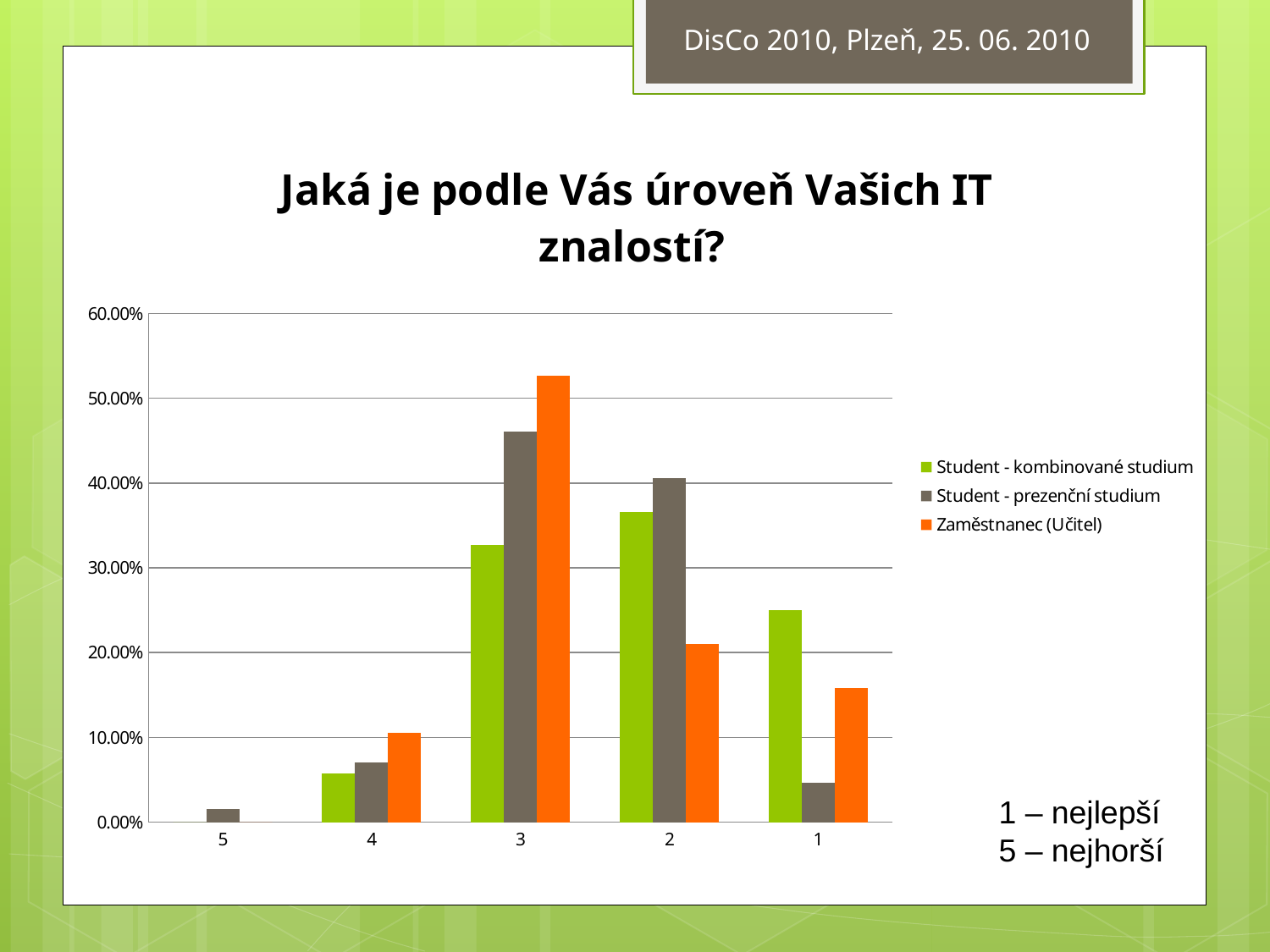
How many series does the legend list? 3 For which category is the value for Student - kombinované studium highest? 2 Is the value for Zaměstnanec (Učitel) at category 3 greater or less than 50.00%? greater At category 2, which is larger: Student - prezenční studium or Zaměstnanec (Učitel)? Student - prezenční studium For which category is the value for Student - prezenční studium lowest? 5 Is the value for Student - kombinované studium at category 1 greater or less than 20.00%? greater What kind of chart is shown on the slide? bar chart Is the value for Student - prezenční studium at category 3 greater or less than 50.00%? less What is the title of the chart? Jaká je podle Vás úroveň Vašich IT znalostí? How many categories are shown on the x axis? 5 For which category is the value for Zaměstnanec (Učitel) highest? 3 At category 1, which is larger: Student - kombinované studium or Zaměstnanec (Učitel)? Student - kombinované studium